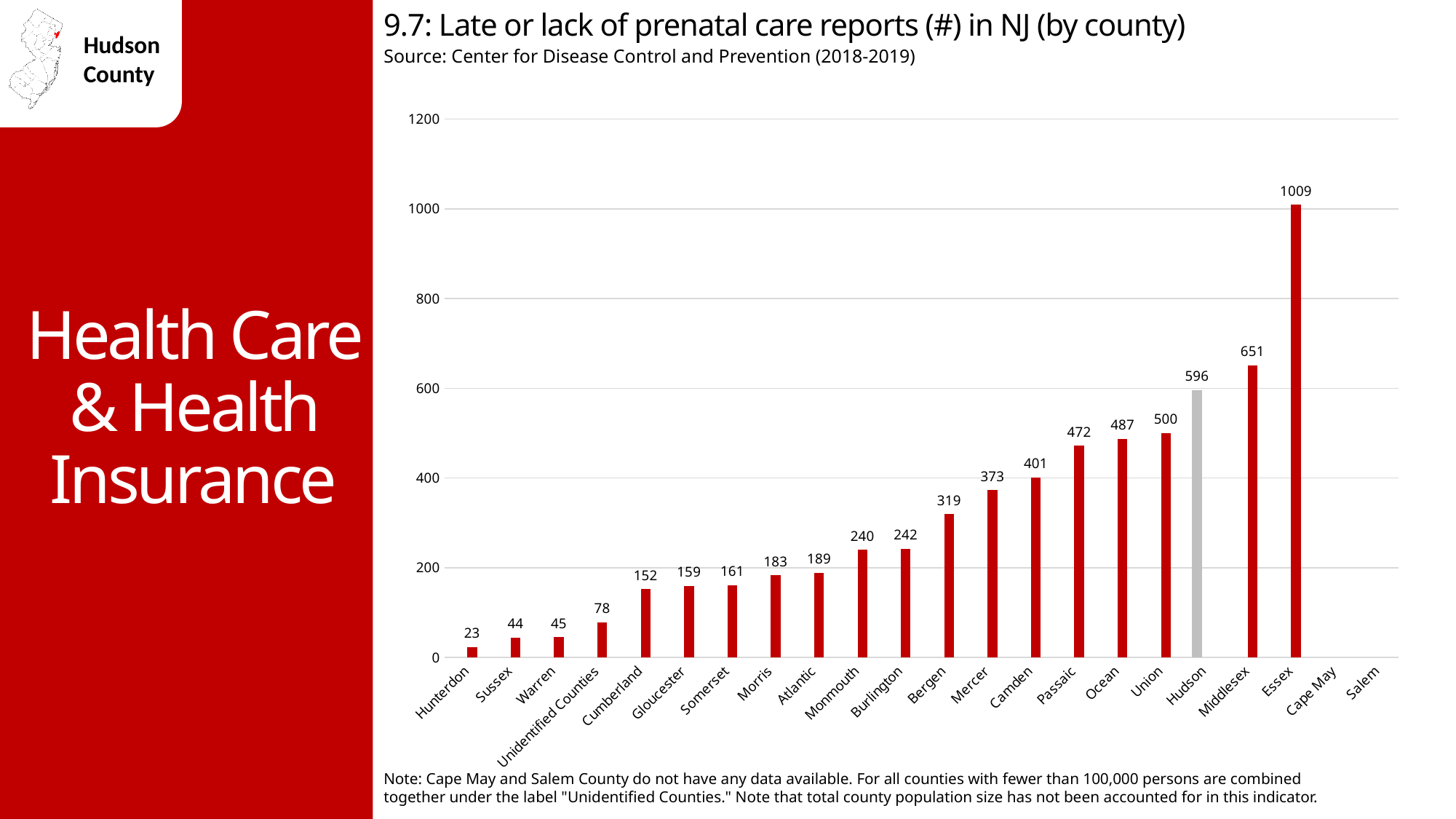
What kind of chart is shown on the slide? Bar chart What value is shown for Essex County? 1009 Is the value for Bergen greater or less than 400? less Which county has the highest number of late or lack of prenatal care reports? Essex What is the difference between the values for Essex and Middlesex? 358 Among the counties with a plotted bar, which has the lowest value? Hunterdon What value is shown for Cumberland County? 152 Which county's bar is coloured grey instead of red? Hudson Which is larger, the value for Passaic or the value for Ocean? Ocean How much higher is Hudson's value than Union's? 96 How many county labels are listed along the x axis? 22 What is the number of late or lack of prenatal care reports for Hudson County? 596